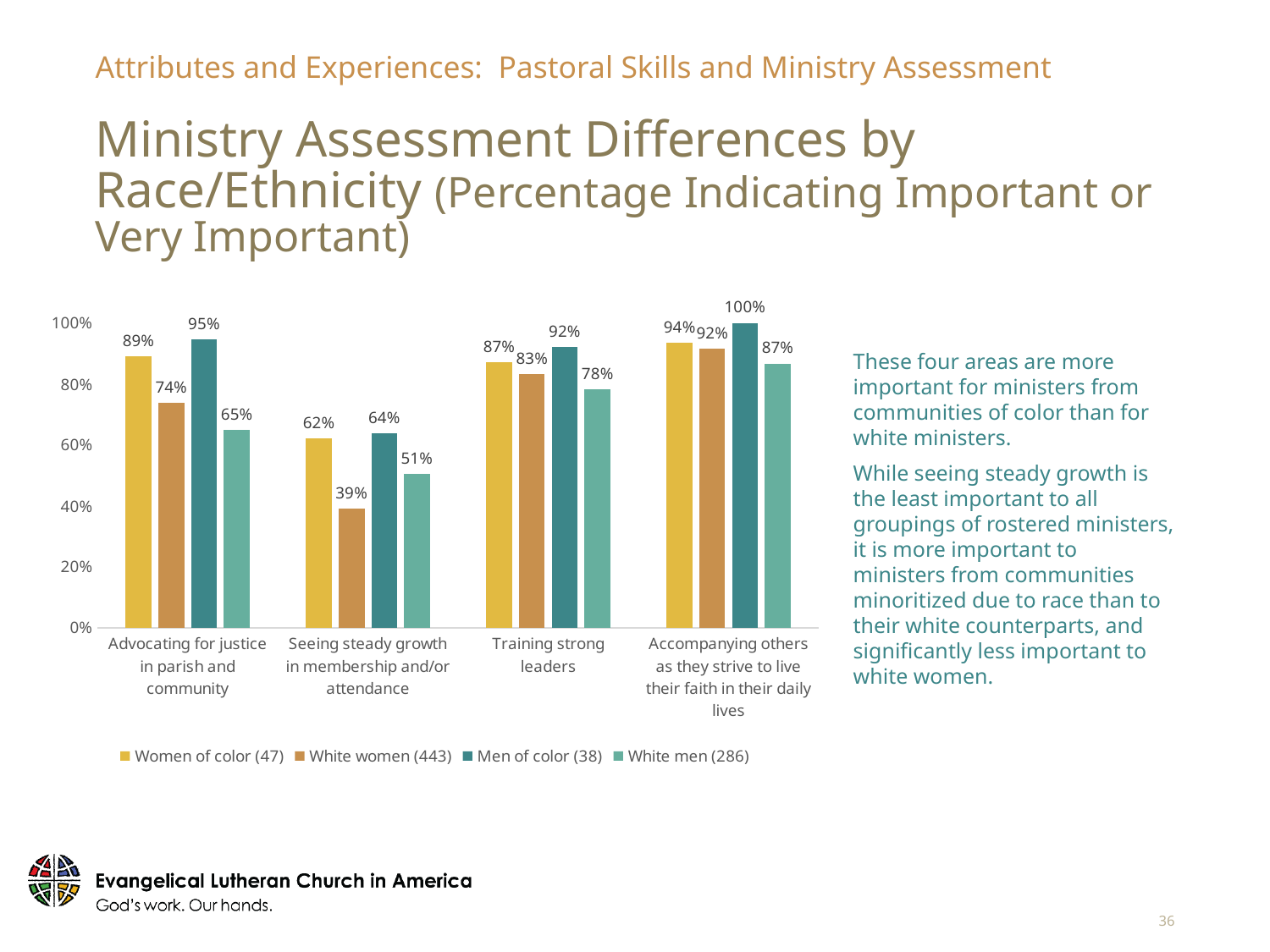
What is the value for White men for 'Training strong leaders'? 78% Which group has the highest value for 'Accompanying others as they strive to live their faith in their daily lives'? Men of color What percentage of Men of color rated 'Advocating for justice in parish and community' as important or very important? 95% What is the difference between the Women of color and White women values for 'Advocating for justice in parish and community'? 15 percentage points Is the value for White men for 'Seeing steady growth in membership and/or attendance' greater or less than 60%? less According to the legend, how many White women respondents are included? 443 Which is larger for 'Training strong leaders': the value for Women of color or the value for White women? Women of color What is the value for White women for 'Seeing steady growth in membership and/or attendance'? 39% What kind of chart is shown on the slide? Bar chart How many categories are shown on the x axis of the chart? 4 Which group has the lowest value for 'Seeing steady growth in membership and/or attendance'? White women How many series does the legend list? 4